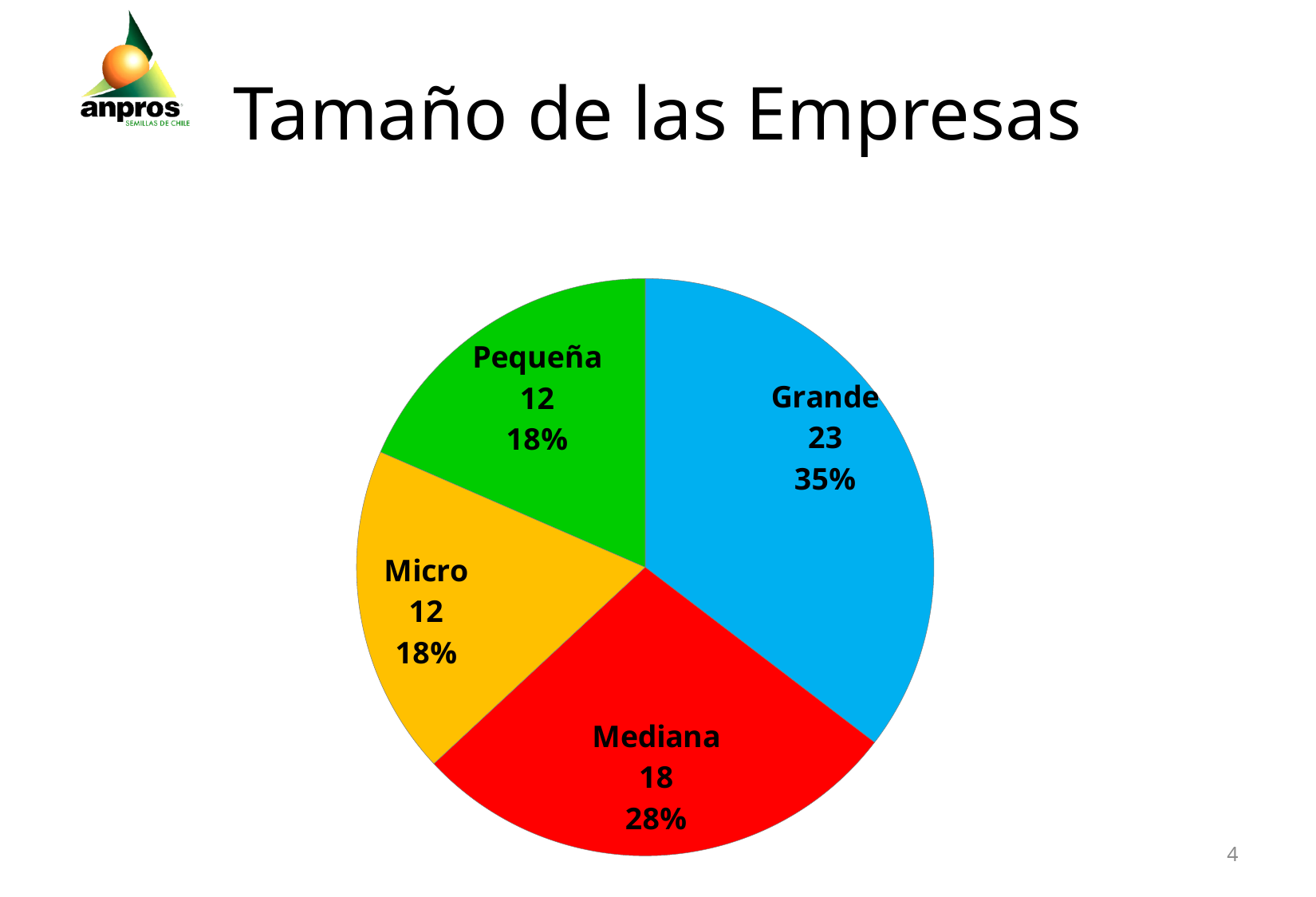
What is the total of all four slice values? 65 What percentage share does Grande have? 35% Which is larger, the value for Mediana or the value for Pequeña? Mediana What is the value for Grande? 23 Which category has the largest slice? Grande How many slices does the pie chart have? 4 What is the difference between the values for Grande and Mediana? 5 What is the value for Micro? 12 What colour is the Mediana slice? Red What kind of chart is shown on the slide? Pie chart What percentage share does Pequeña have? 18% What is the value for Mediana? 18